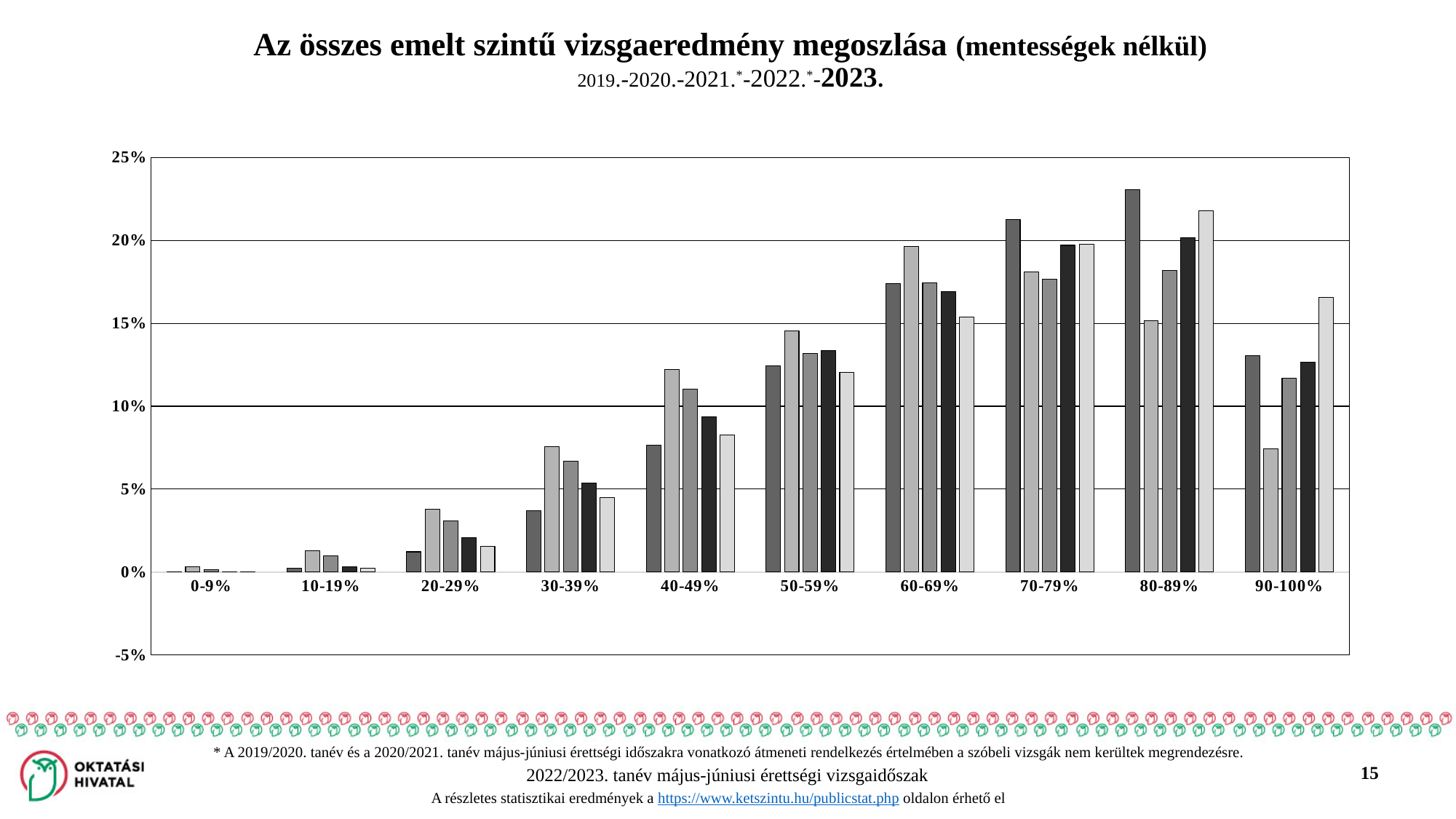
Is the value of the leftmost bar in the 70-79% group greater or less than 20%? greater Is the value of the rightmost (lightest) bar in the 90-100% group greater or less than 15%? greater What kind of chart is shown on the slide? bar chart Which score band has the lowest bars in the chart? 0-9% How many score-band categories are shown on the x axis? 10 What is the title of the chart? Az összes emelt szintű vizsgaeredmény megoszlása (mentességek nélkül) Is the value of the leftmost bar in the 40-49% group greater or less than 10%? less In the 60-69% group, which is taller, the first bar or the second bar? the second bar How many bars are plotted for each score-band category? 5 Which score band contains the tallest bar in the chart? 80-89% Moving from the 0-9% band to the 80-89% band, do the bar values generally rise or fall? rise